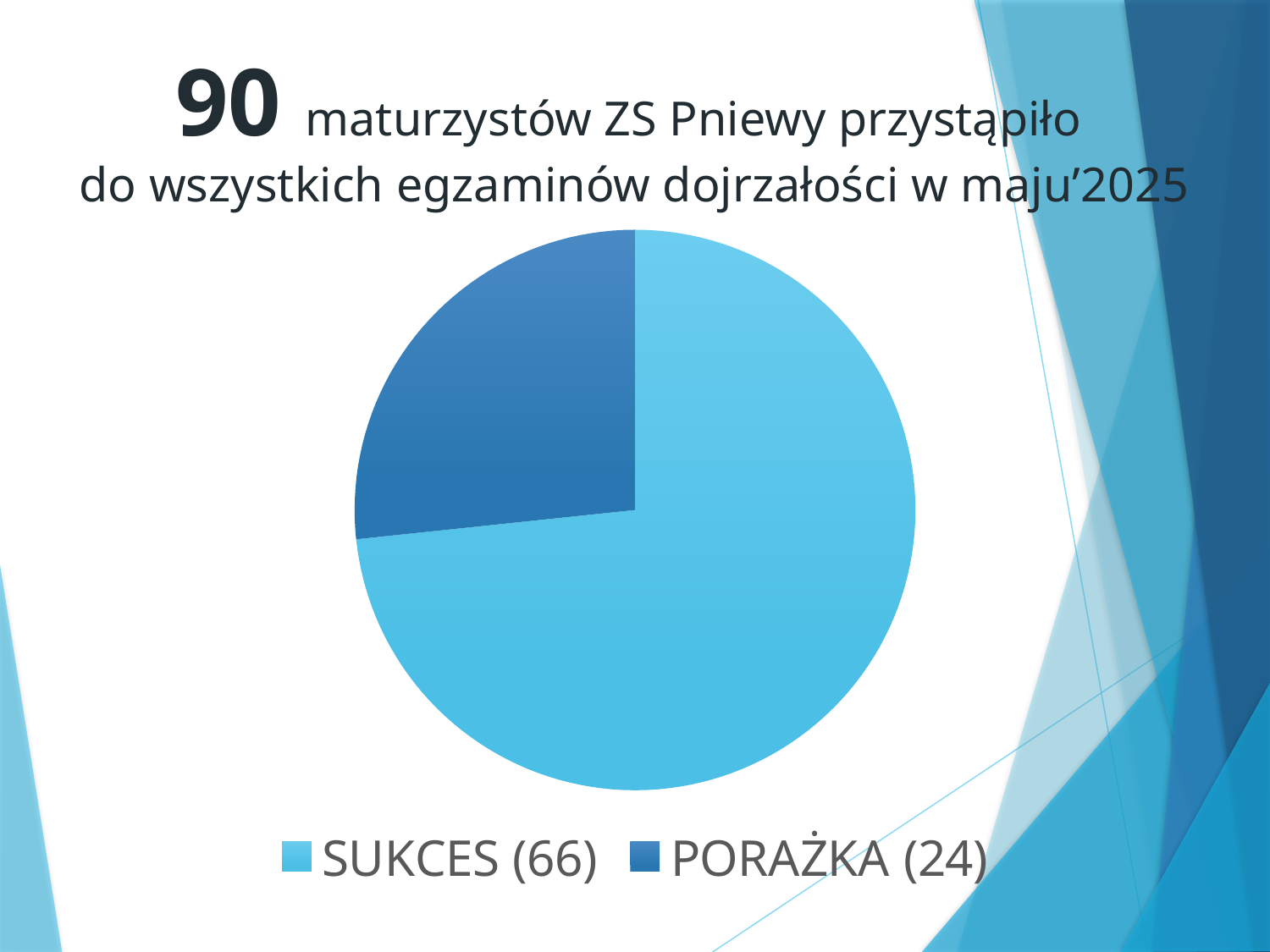
How many slices does the pie chart have? 2 How many entries does the legend of the pie chart list? 2 What is the value for PORAŻKA in the pie chart? 24 Which category has the smallest slice in the pie chart? PORAŻKA Which is larger, the value for SUKCES or the value for PORAŻKA? SUKCES What is the total of the two values shown in the pie chart? 90 According to the slide text, how many maturzystów ZS Pniewy took all the exams in May 2025? 90 What kind of chart is shown on the slide? pie chart Which category has the largest slice in the pie chart? SUKCES What is the difference between the values for SUKCES and PORAŻKA? 42 What is the value for SUKCES in the pie chart? 66 Which legend entry is shown in the darker blue colour? PORAŻKA (24)